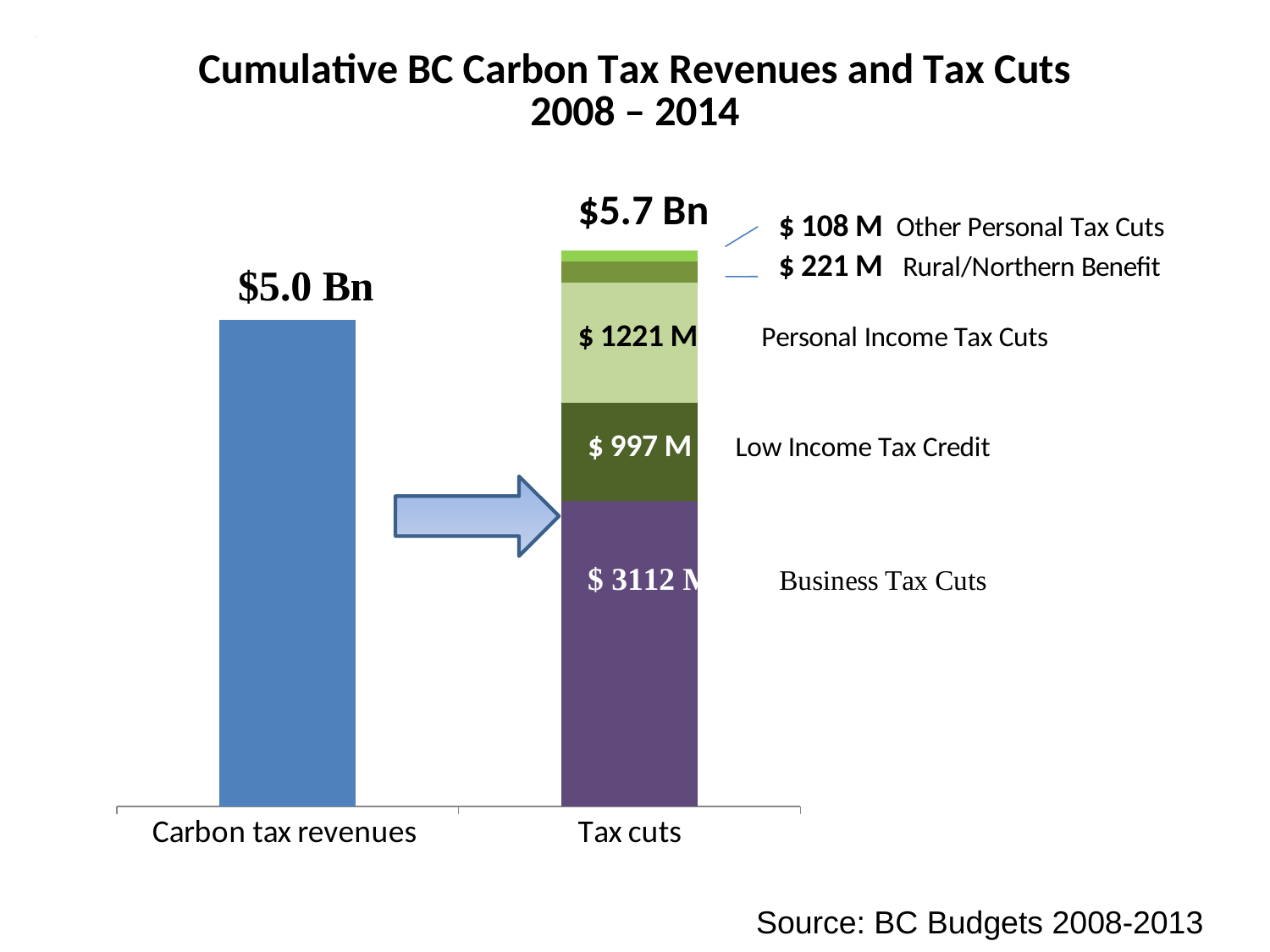
What is the value of the Rural/Northern Benefit segment? $ 221 M Which is larger, Carbon tax revenues or Tax cuts? Tax cuts What is the value of the Business Tax Cuts segment in the Tax cuts bar? $ 3112 M How many segments make up the Tax cuts bar? 5 Which segment of the Tax cuts bar is the smallest? Other Personal Tax Cuts What is the value of the Personal Income Tax Cuts segment? $ 1221 M What is the value shown for Carbon tax revenues? $5.0 Bn Which segment of the Tax cuts bar is the largest? Business Tax Cuts What is the value of the Low Income Tax Credit segment? $ 997 M What is the total value shown for the Tax cuts bar? $5.7 Bn What type of chart is shown on the slide? Bar chart What is the difference between the Business Tax Cuts segment and the Low Income Tax Credit segment? $ 2115 M